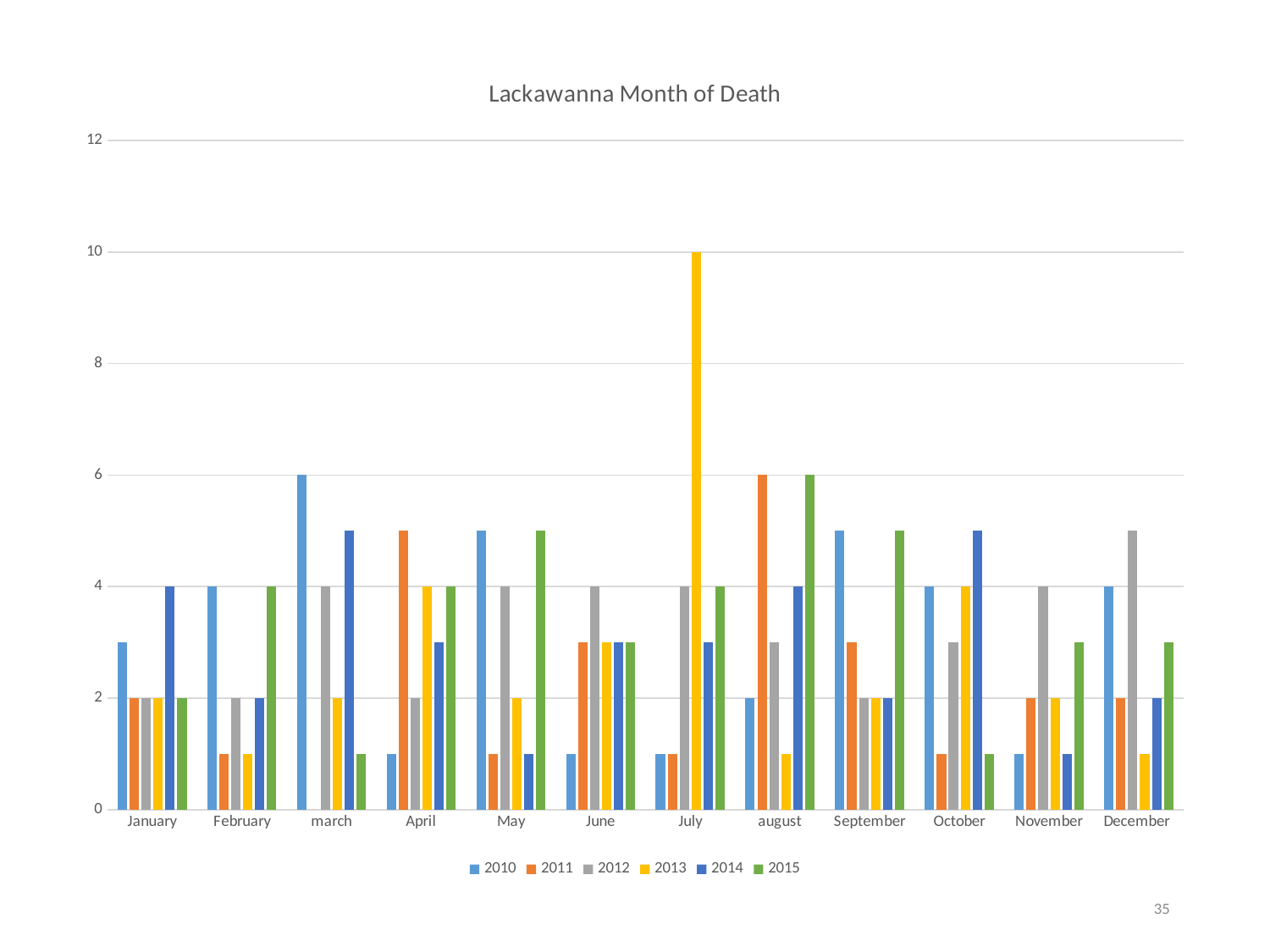
Which is larger: the 2010 value in March or the 2010 value in April? March Which month and year has the highest bar in the chart? July, 2013 Is the value for 2014 in March greater or less than 4? greater What is the difference between the 2013 value and the 2012 value in July? 6 What is the value for 2010 in March? 6 What type of chart is shown on the slide? bar chart Is the value for 2011 in April greater or less than 4? greater How many series does the legend list? 6 What is the value for 2011 in August? 6 What is the value for 2013 in July? 10 What is the title of the chart? Lackawanna Month of Death How many month categories are shown on the x axis? 12